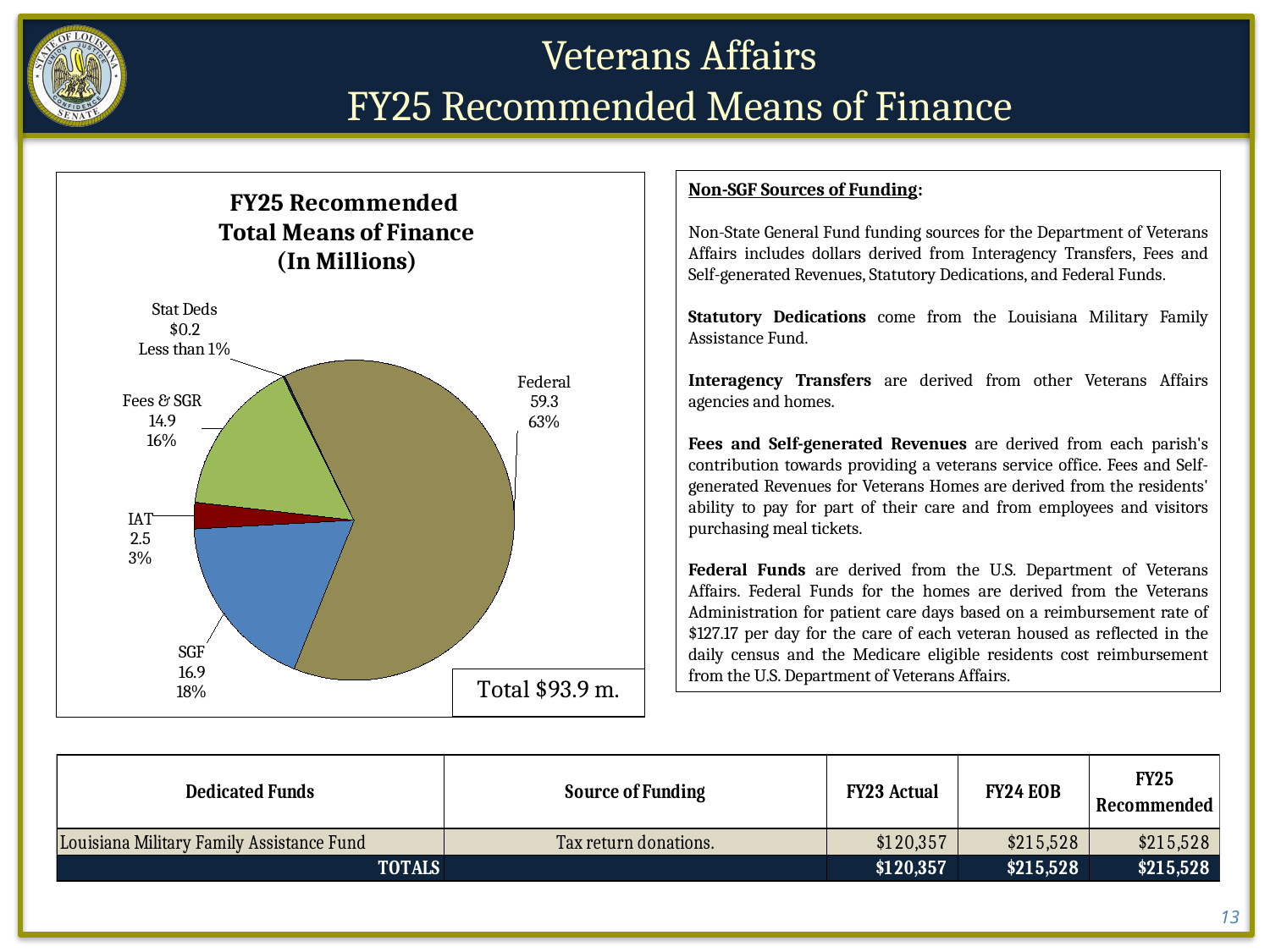
What share of the pie does Federal represent? 63% What is the title of the chart? FY25 Recommended Total Means of Finance (In Millions) Which category is the largest slice of the pie chart? Federal What is the value shown for Fees & SGR in the pie chart? 14.9 What is the value shown for SGF in the pie chart? 16.9 What is the value shown for Federal in the pie chart? 59.3 What is the difference between the SGF value and the Fees & SGR value in the pie chart? 2.0 How many slices does the pie chart have? 5 What is the value shown for IAT in the pie chart? 2.5 What kind of chart is shown on the slide? Pie chart What share of the pie does SGF represent? 18% Which category is the smallest slice of the pie chart? Stat Deds